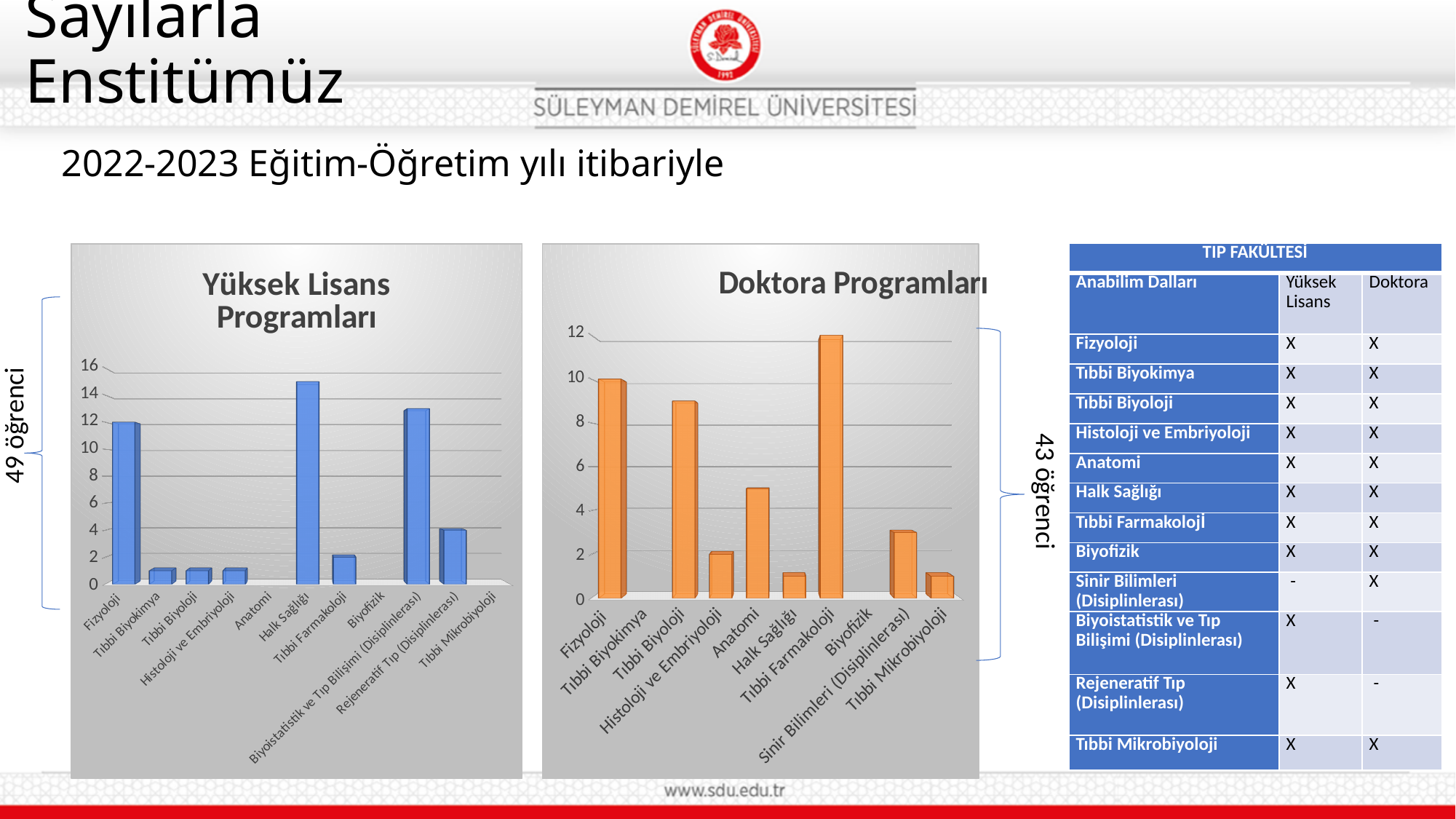
What kind of chart is the "Yüksek Lisans Programları" chart? bar chart In the "Doktora Programları" chart, which program has the highest value? Tıbbi Farmakoloji How many program categories are shown on the x axis of the "Doktora Programları" chart? 10 In the "Yüksek Lisans Programları" chart, which is larger, Halk Sağlığı or Biyoistatistik ve Tıp Bilişimi (Disiplinlerası)? Halk Sağlığı In the "Yüksek Lisans Programları" chart, which program has the highest value? Halk Sağlığı How many program categories are shown on the x axis of the "Yüksek Lisans Programları" chart? 11 What colour are the bars in the "Doktora Programları" chart? orange In the "Doktora Programları" chart, is the value for Anatomi greater or less than 4? greater In the "Doktora Programları" chart, which is larger, Fizyoloji or Tıbbi Biyoloji? Fizyoloji In the "Doktora Programları" chart, is the value for Histoloji ve Embriyoloji greater or less than 4? less In the "Yüksek Lisans Programları" chart, is the value for Fizyoloji greater or less than 10? greater